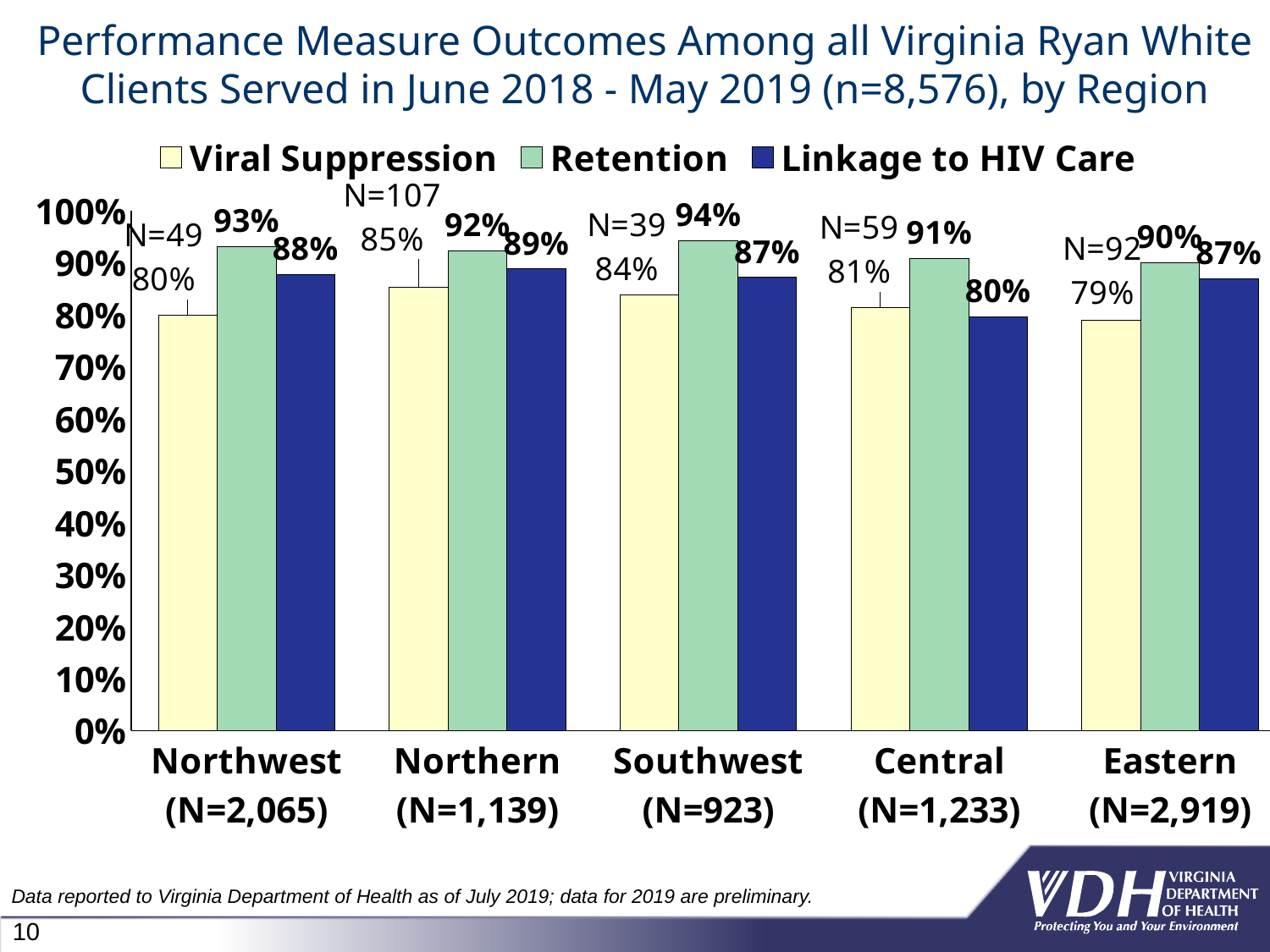
What kind of chart is shown on the slide? Bar chart What is the difference between the Retention and Viral Suppression values for the Northwest region? 13 percentage points What is the Retention value for the Southwest region? 94% Which region has the larger Linkage to HIV Care value, Northern or Eastern? Northern What is the Viral Suppression value for the Northern region? 85% Which region has the lowest Viral Suppression value? Eastern What is the Linkage to HIV Care value for the Central region? 80% How many series does the legend list? 3 Which region has the highest Retention value? Southwest What are the three series listed in the legend? Viral Suppression, Retention, Linkage to HIV Care What is the Retention value for the Eastern region? 90% How many regions are shown on the x axis? 5